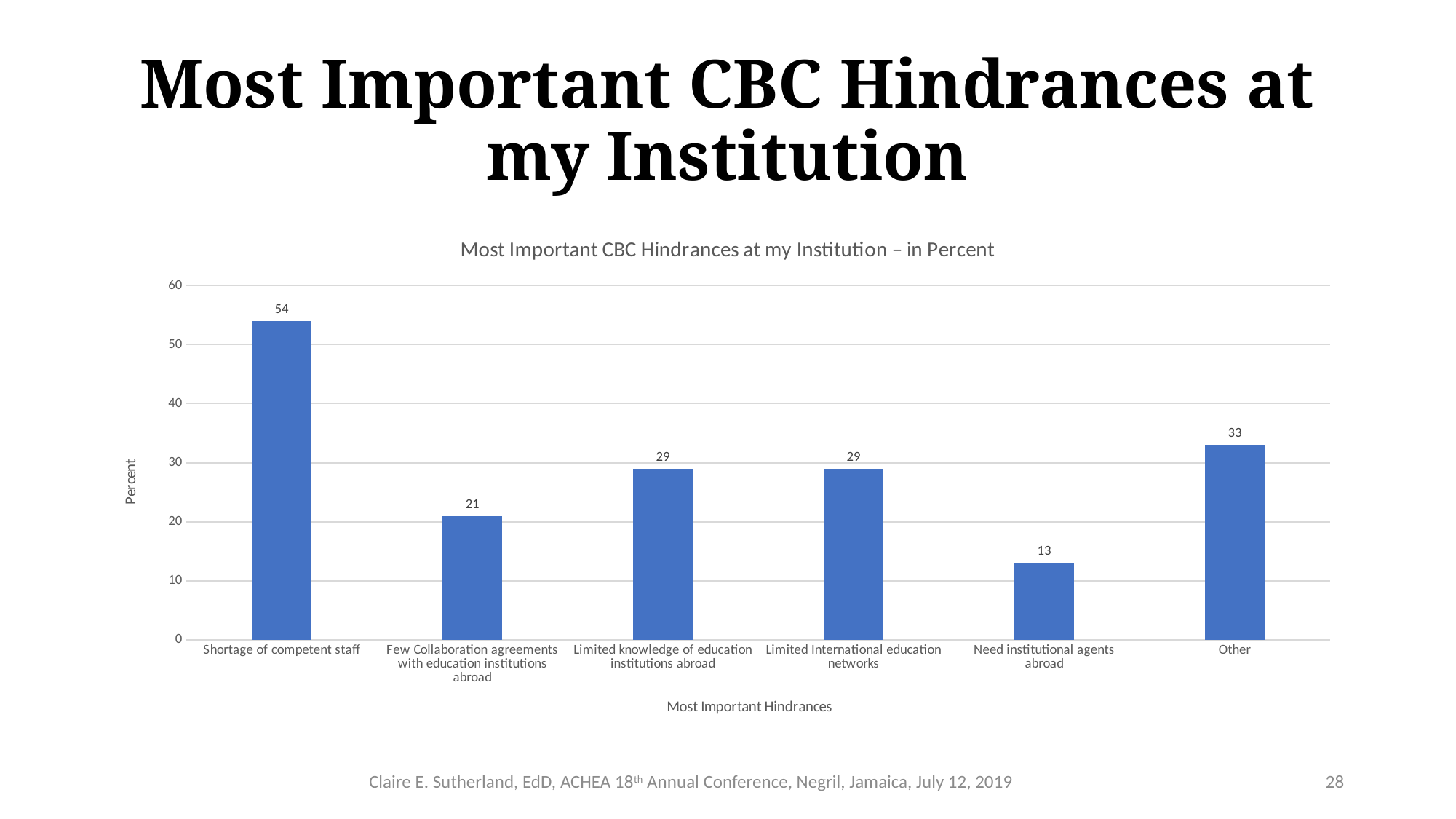
Which is larger, the value for Other or the value for Limited International education networks? Other Is the value for Limited knowledge of education institutions abroad greater or less than 20? greater How many hindrance categories are shown on the x axis? 6 What is the difference between the values for Shortage of competent staff and Other? 21 What is the value for Other? 33 What is the label of the vertical axis? Percent What is the value for Need institutional agents abroad? 13 What is the value for Shortage of competent staff? 54 What kind of chart is shown on the slide? Bar chart Which hindrance has the highest value? Shortage of competent staff Which hindrance has the lowest value? Need institutional agents abroad What is the value for Few Collaboration agreements with education institutions abroad? 21